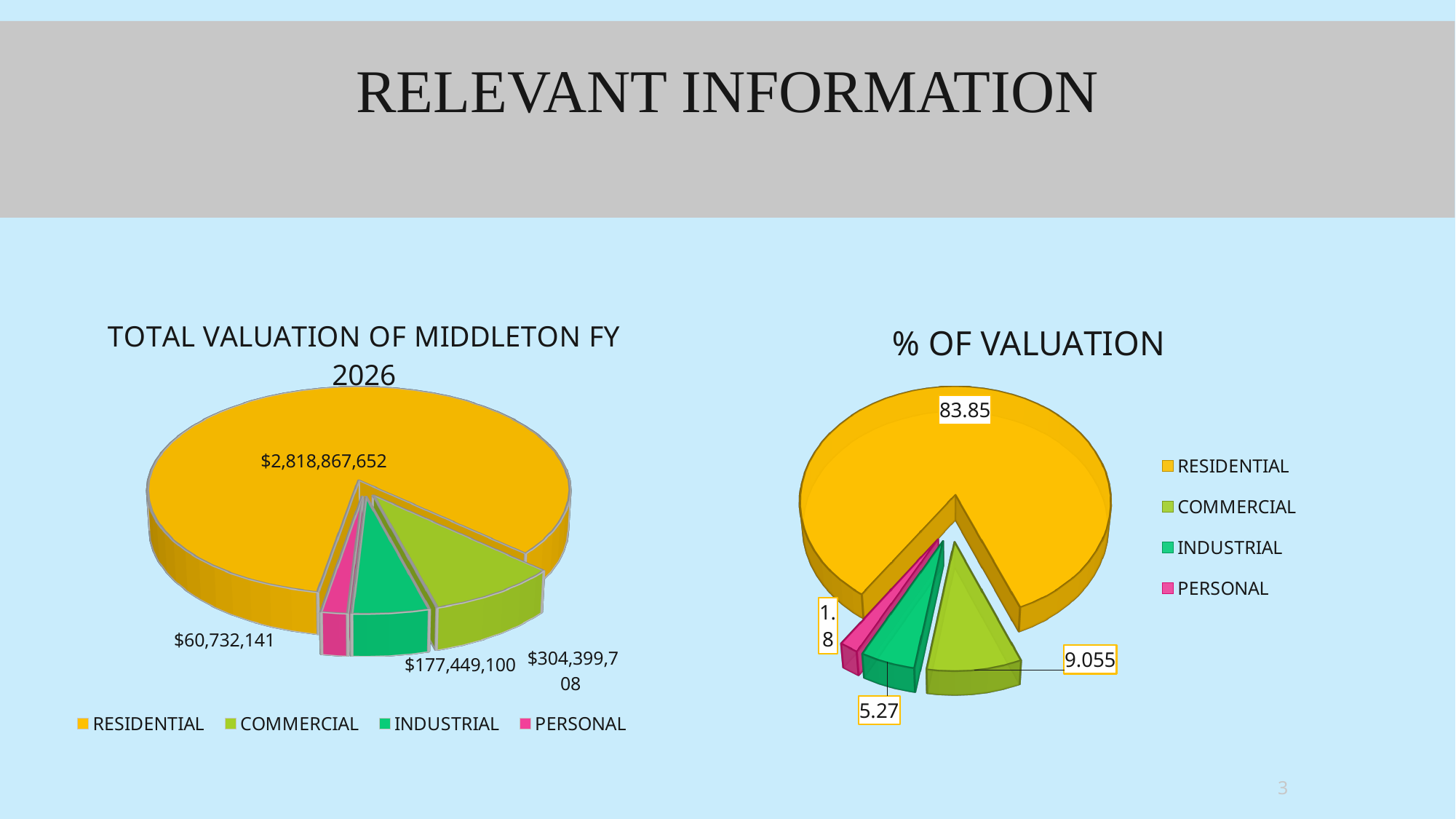
In the "TOTAL VALUATION OF MIDDLETON FY 2026" chart, what is the value for RESIDENTIAL? $2,818,867,652 In the "TOTAL VALUATION OF MIDDLETON FY 2026" chart, how many categories does the legend list? 4 In the "% OF VALUATION" chart, which category has the largest slice? RESIDENTIAL What kind of chart is the "TOTAL VALUATION OF MIDDLETON FY 2026" chart? Pie chart In the "% OF VALUATION" chart, which is larger, COMMERCIAL or INDUSTRIAL? COMMERCIAL In the "% OF VALUATION" chart, what is the value for COMMERCIAL? 9.055 In the "TOTAL VALUATION OF MIDDLETON FY 2026" chart, what is the value for COMMERCIAL? $304,399,708 In the "% OF VALUATION" chart, what is the value for INDUSTRIAL? 5.27 In the "TOTAL VALUATION OF MIDDLETON FY 2026" chart, what is the value for INDUSTRIAL? $177,449,100 In the "TOTAL VALUATION OF MIDDLETON FY 2026" chart, what is the value for PERSONAL? $60,732,141 In the "% OF VALUATION" chart, what is the value for RESIDENTIAL? 83.85 In the "TOTAL VALUATION OF MIDDLETON FY 2026" chart, which category has the smallest slice? PERSONAL